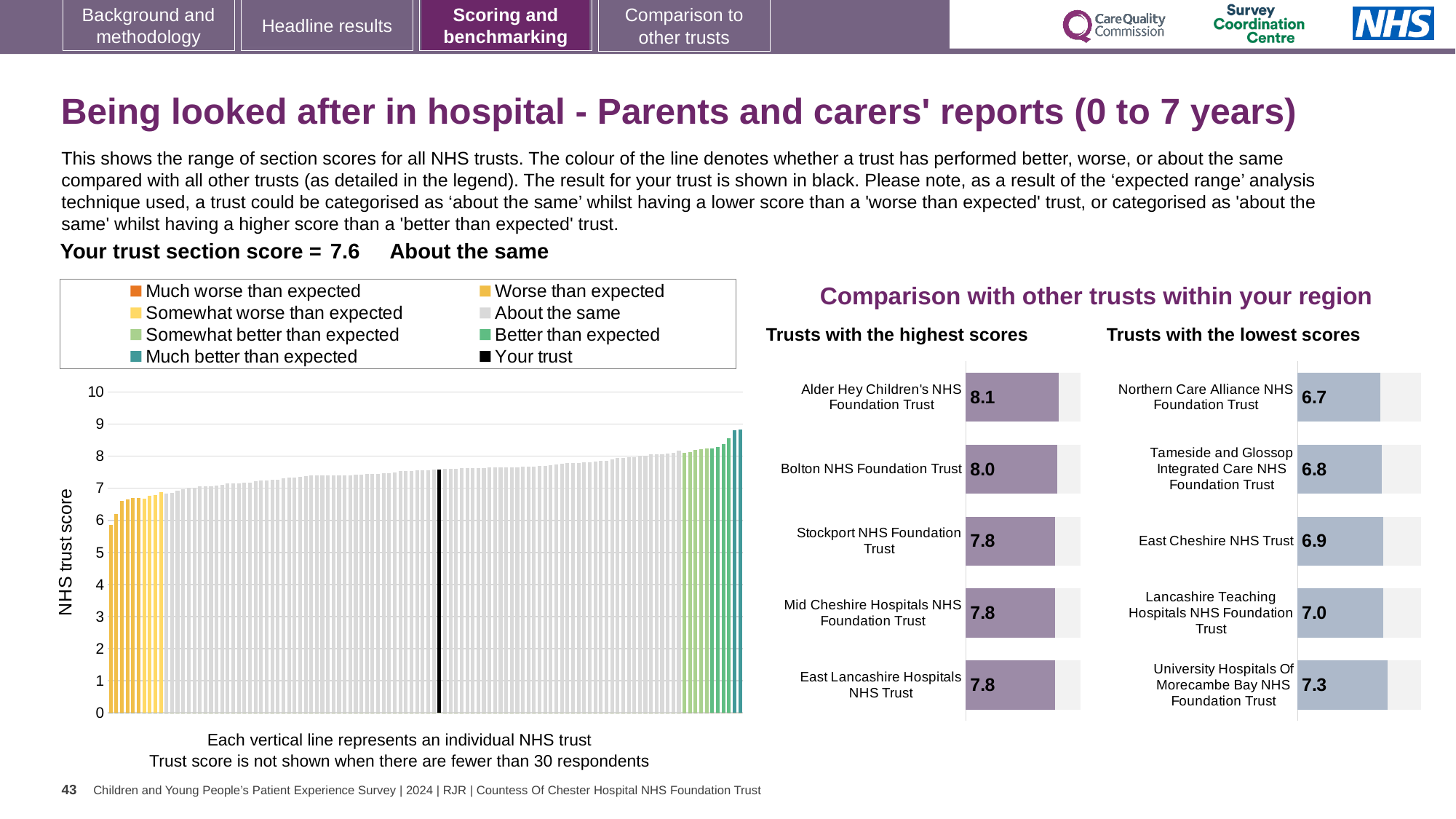
In the 'Trusts with the lowest scores' chart, which has the larger score: Tameside and Glossop Integrated Care NHS Foundation Trust or Lancashire Teaching Hospitals NHS Foundation Trust? Lancashire Teaching Hospitals NHS Foundation Trust In the large chart on the left, is the value of the black bar (your trust) greater or less than 7? greater In the 'Trusts with the highest scores' chart, what is the score for Alder Hey Children's NHS Foundation Trust? 8.1 How many trusts are listed in the 'Trusts with the highest scores' chart? 5 What kind of chart is the large chart on the left showing NHS trust scores? Bar chart In the large chart on the left, do the trust scores rise or fall from left to right? Rise In the 'Trusts with the highest scores' chart, which trust has the highest score? Alder Hey Children's NHS Foundation Trust In the 'Trusts with the lowest scores' chart, which trust has the lowest score? Northern Care Alliance NHS Foundation Trust In the 'Trusts with the lowest scores' chart, what is the difference between the scores of University Hospitals Of Morecambe Bay NHS Foundation Trust and Northern Care Alliance NHS Foundation Trust? 0.6 How many entries does the legend of the large chart on the left list? 8 In the 'Trusts with the highest scores' chart, what is the difference between the scores of Alder Hey Children's NHS Foundation Trust and Bolton NHS Foundation Trust? 0.1 In the 'Trusts with the lowest scores' chart, what is the score for East Cheshire NHS Trust? 6.9